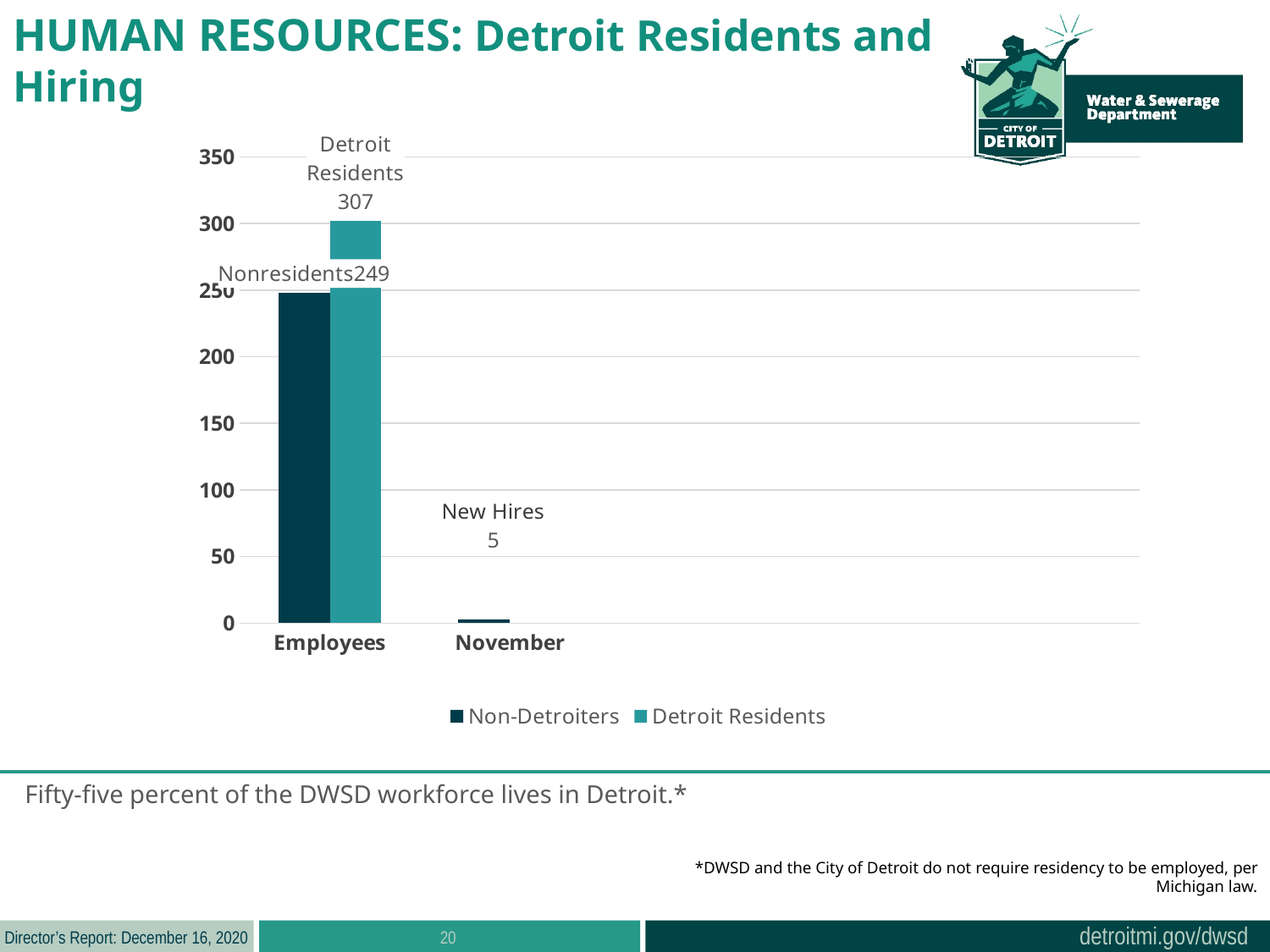
Is the New Hires value for November greater or less than 50? less What is the value of the Non-Detroiters (Nonresidents) bar for Employees? 249 How many series does the legend list? 2 How many categories are shown on the x axis? 2 What is the difference between the Detroit Residents and Nonresidents values for Employees? 58 How many New Hires are shown for November? 5 For Employees, which is larger: Detroit Residents or Non-Detroiters? Detroit Residents What is the value of the Detroit Residents bar for Employees? 307 What are the two series named in the legend? Non-Detroiters and Detroit Residents Is the Non-Detroiters value for Employees greater or less than 200? greater What kind of chart is shown on the slide? bar chart What is the total of the Detroit Residents and Nonresidents values for Employees? 556